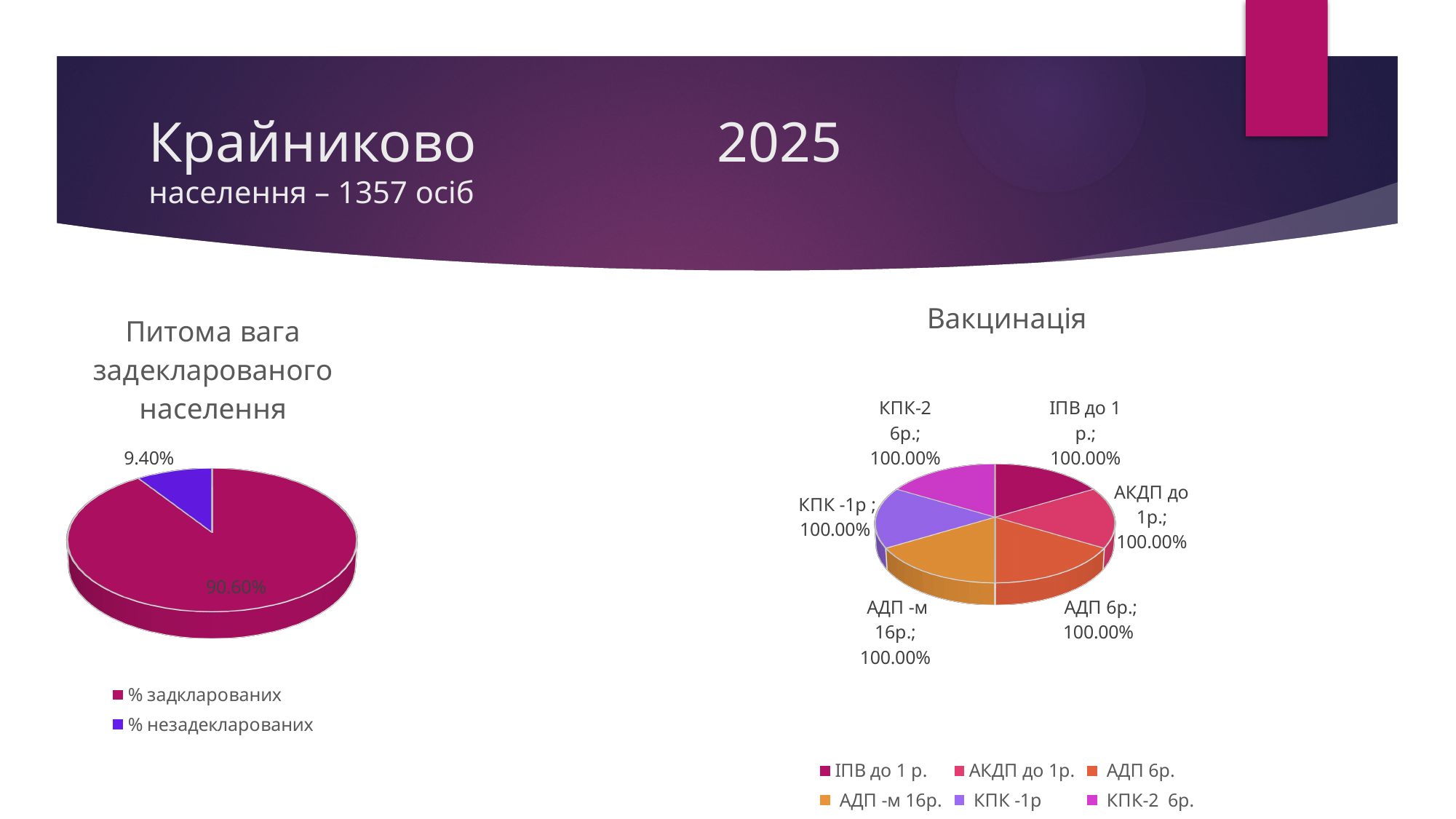
In the chart titled "Питома вага задекларованого населення", what is the difference between the two slice values? 81.20% In the chart titled "Питома вага задекларованого населення", what is the value for "% задклярованих"? 90.60% In the chart titled "Вакцинація", what value is shown for "АДП 6р."? 100.00% In the chart titled "Вакцинація", what value is shown for "КПК -1р"? 100.00% In the chart titled "Вакцинація", how many slices does the pie have? 6 What kind of chart is the chart titled "Вакцинація"? Pie chart In the chart titled "Питома вага задекларованого населення", how many entries does the legend list? 2 In the chart titled "Питома вага задекларованого населення", which category has the smallest slice? % незадекларованих In the chart titled "Питома вага задекларованого населення", what is the value for "% незадекларованих"? 9.40% What kind of chart is the chart titled "Питома вага задекларованого населення"? Pie chart In the chart titled "Вакцинація", how many entries does the legend list? 6 In the chart titled "Питома вага задекларованого населення", which category has the largest slice? % задкларованих